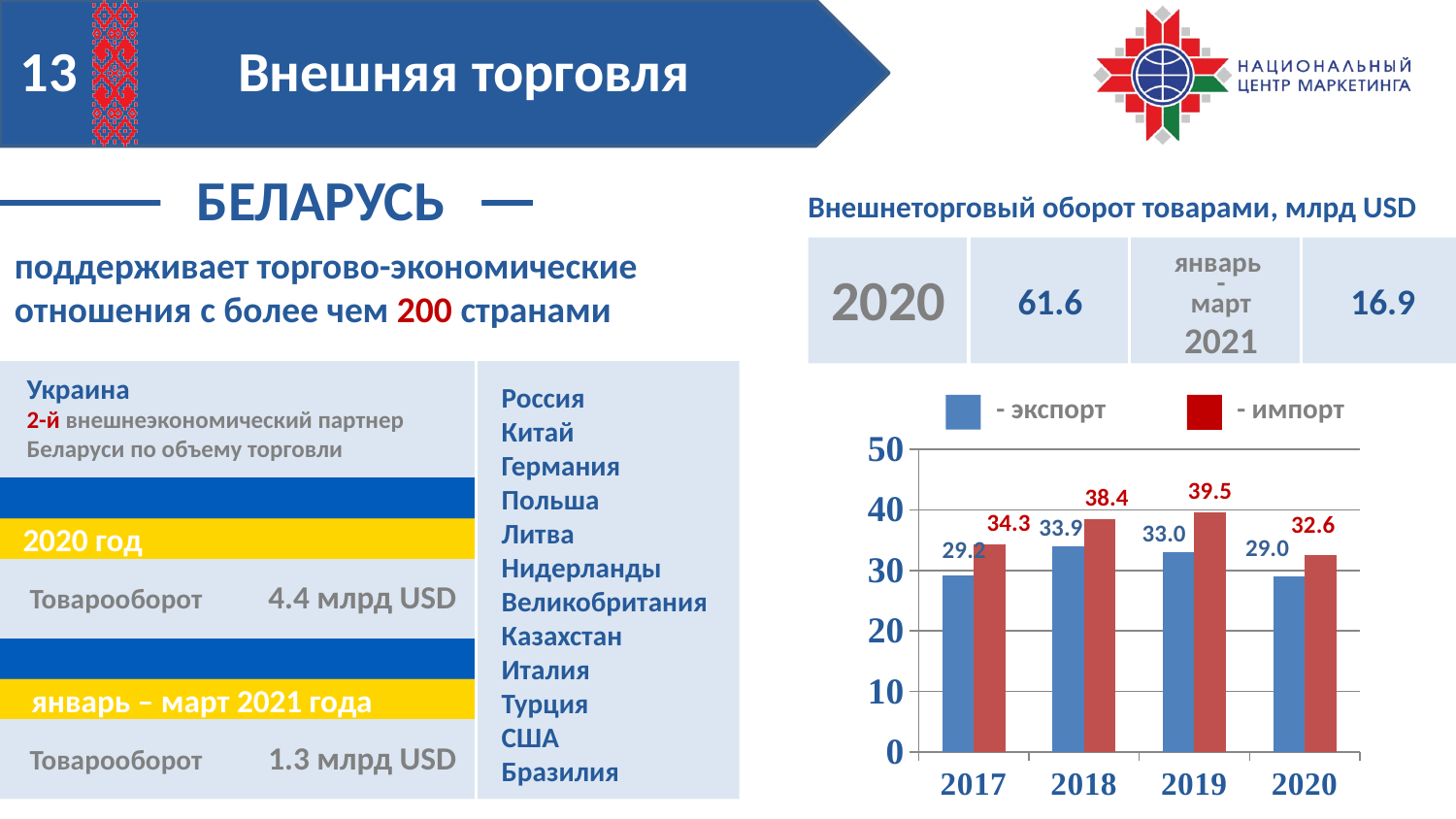
What was the import value in 2019? 39.5 How many series does the chart legend list? 2 What is the difference between import and export in 2017? 5.1 In which year was export the lowest? 2020 How many years are shown on the x axis of the chart? 4 What was the export value in 2018? 33.9 Which was larger in 2020, export or import? import What was the export value in 2020? 29.0 In which year was import the highest? 2019 What type of chart is shown on the slide? bar chart Is the import value for 2018 greater or less than 30? greater Which colour represents import in the chart? red